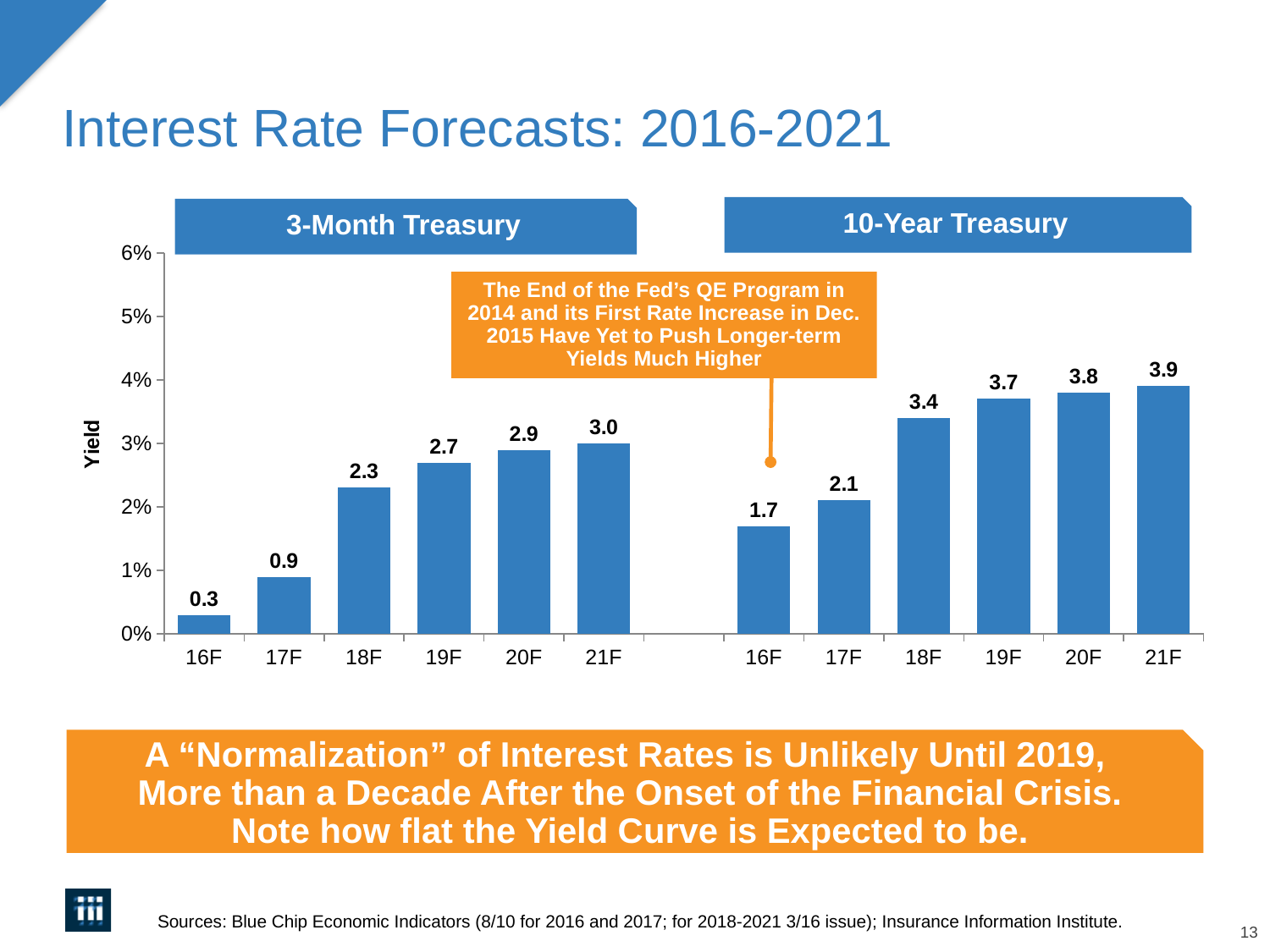
Which year has the highest forecast 10-Year Treasury yield? 21F What is the forecast 3-Month Treasury yield for 18F? 2.3 What is the forecast 10-Year Treasury yield for 21F? 3.9 Do the 10-Year Treasury forecast yields rise or fall from 16F to 21F? Rise Which year has the lowest forecast 3-Month Treasury yield? 16F What is the difference between the 3-Month Treasury forecast yields for 18F and 17F? 1.4 How many forecast years are shown for the 3-Month Treasury? 6 Is the 10-Year Treasury forecast yield for 18F greater or less than 3%? greater What is the difference between the 10-Year Treasury and 3-Month Treasury forecast yields for 16F? 1.4 What is the forecast 10-Year Treasury yield for 16F? 1.7 Which is larger: the 3-Month Treasury forecast for 21F or the 10-Year Treasury forecast for 17F? 3-Month Treasury forecast for 21F What type of chart is shown on the slide? Bar chart